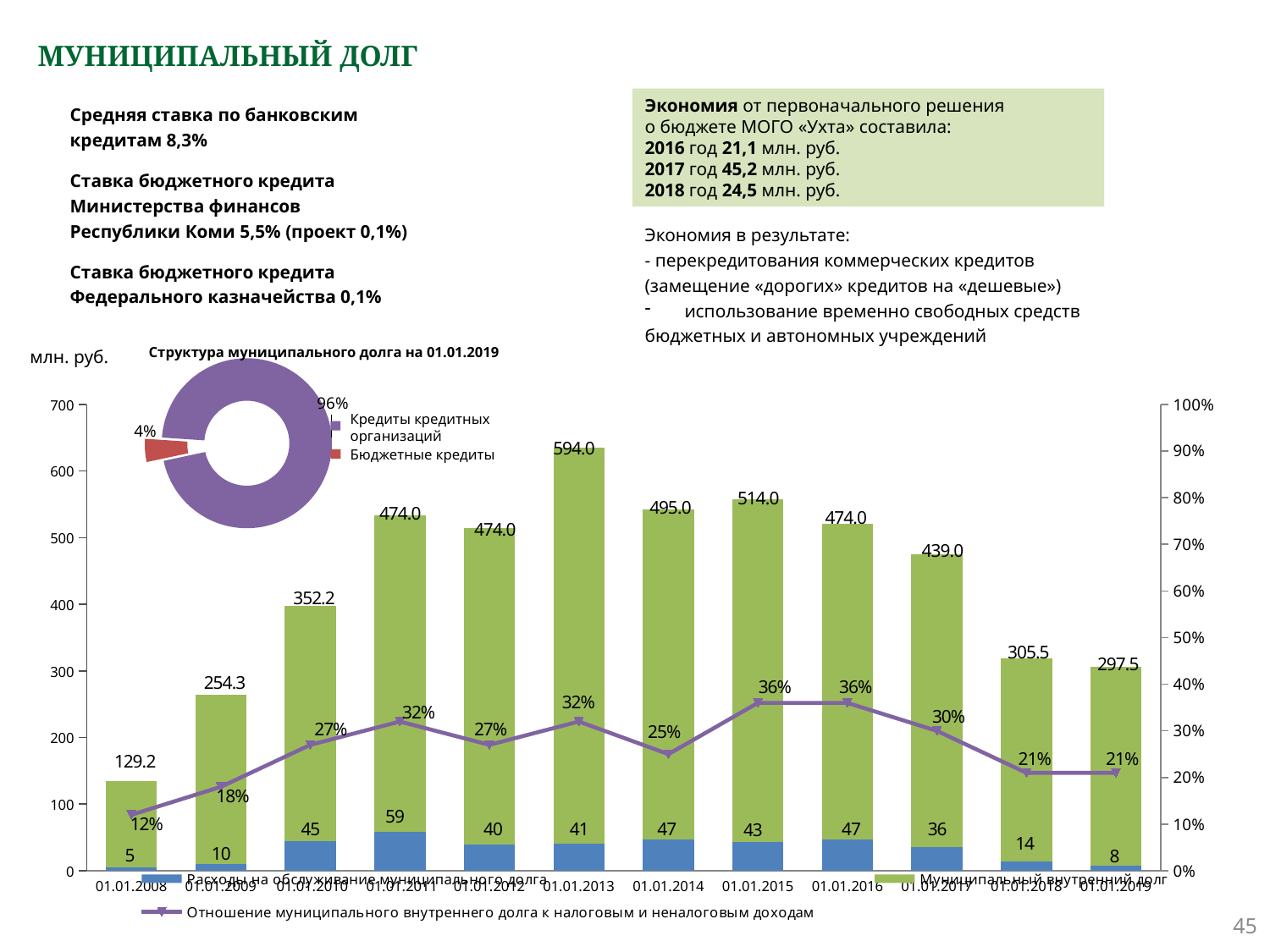
In the large bar chart, what is the difference between 'Муниципальный внутренний долг' on 01.01.2013 and on 01.01.2019? 296.5 In the large bar chart, what is the value of 'Расходы на обслуживание муниципального долга' for 01.01.2011? 59 In the large bar chart, what is the value of 'Муниципальный внутренний долг' for 01.01.2013? 594.0 In the donut chart 'Структура муниципального долга на 01.01.2019', what share is 'Бюджетные кредиты'? 4% In the large bar chart, on which date is 'Муниципальный внутренний долг' highest? 01.01.2013 In the large bar chart, on which date is 'Расходы на обслуживание муниципального долга' lowest? 01.01.2008 How many series does the legend of the large bar chart list? 3 In the large bar chart, what is the value of 'Отношение муниципального внутреннего долга к налоговым и неналоговым доходам' for 01.01.2015? 36% How many dates are shown on the x axis of the large bar chart? 12 In the large bar chart, which is larger: 'Муниципальный внутренний долг' on 01.01.2010 or on 01.01.2018? 01.01.2010 In the donut chart 'Структура муниципального долга на 01.01.2019', what share is 'Кредиты кредитных организаций'? 96% What kind of chart is 'Структура муниципального долга на 01.01.2019'? Pie (donut) chart